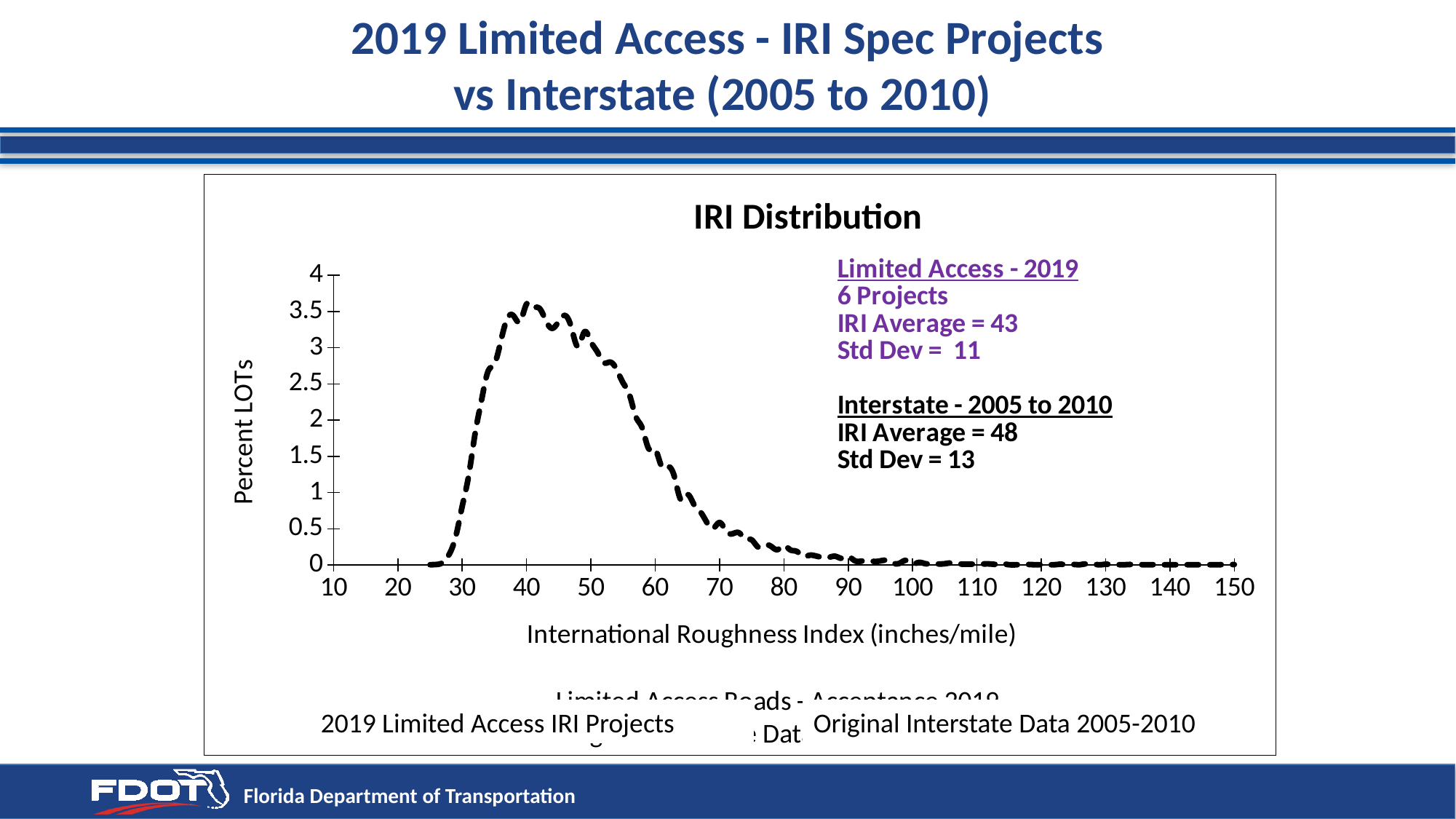
Is the Percent LOTs value of the dashed line at an IRI of 60 greater or less than 2? less What is the label of the y axis of the chart? Percent LOTs Is the Percent LOTs value of the dashed line at an IRI of 40 greater or less than 3? greater Which has the higher IRI Average according to the chart annotation, Limited Access - 2019 or Interstate - 2005 to 2010? Interstate - 2005 to 2010 Between an IRI of 40 and an IRI of 80, does the dashed line rise or fall? fall According to the annotation on the chart, what is the IRI Average for Limited Access - 2019? 43 According to the annotation on the chart, what is the Std Dev for Interstate - 2005 to 2010? 13 What is the difference between the Interstate IRI Average and the Limited Access - 2019 IRI Average shown on the chart? 5 What is the title of the chart? IRI Distribution How many projects are listed for Limited Access - 2019 in the chart annotation? 6 Projects What kind of chart is shown on the slide? Line chart Is the Percent LOTs value of the dashed line at an IRI of 80 greater or less than 0.5? less